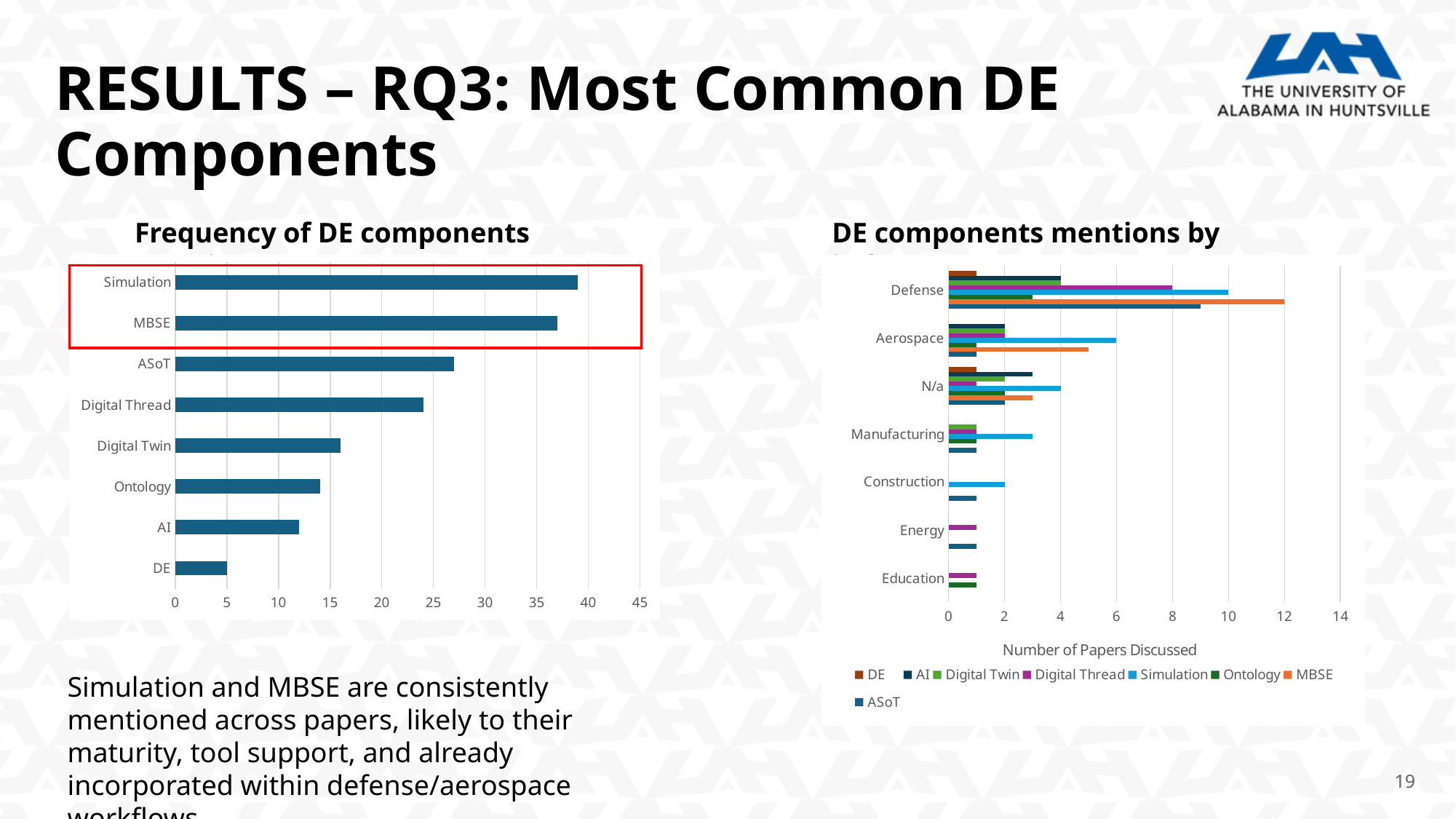
How many series does the legend of the right-hand chart ('DE components mentions by...') list? 8 In the 'Frequency of DE components' chart, which is larger, the value for Digital Thread or the value for Ontology? Digital Thread In the right-hand chart ('DE components mentions by...'), is the MBSE value for Defense greater or less than 10? greater In the 'Frequency of DE components' chart, is the value for ASoT greater or less than 25? greater In the 'Frequency of DE components' chart, is the value for Digital Twin greater or less than 20? less In the 'Frequency of DE components' chart, which component has the highest frequency? Simulation What kind of chart is the 'Frequency of DE components' chart on the left? bar chart How many components are listed in the 'Frequency of DE components' chart? 8 What is the x-axis title of the right-hand chart ('DE components mentions by...')? Number of Papers Discussed In the 'Frequency of DE components' chart, which component has the lowest frequency? DE How many industry categories are shown on the y axis of the right-hand chart ('DE components mentions by...')? 7